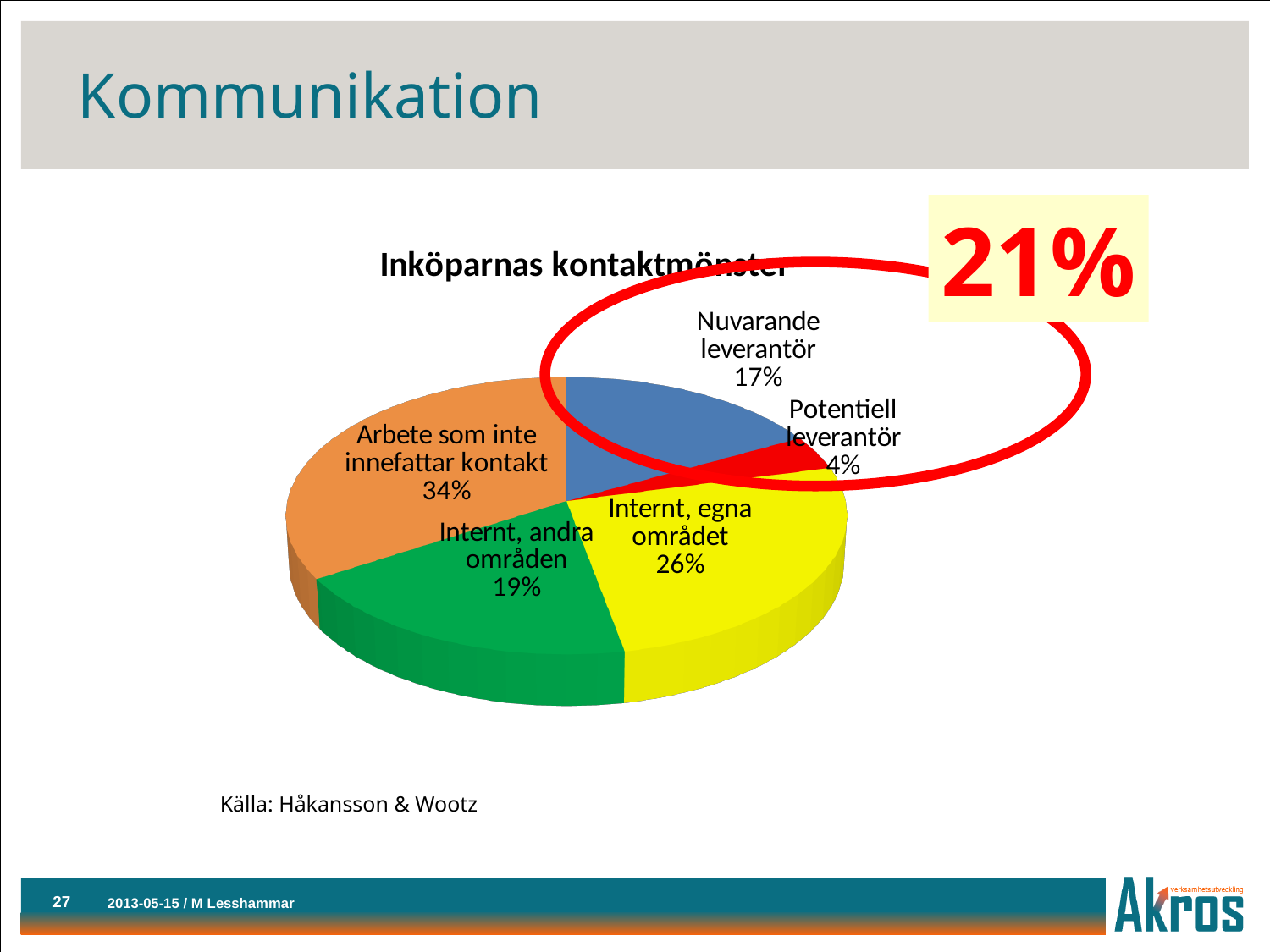
What kind of chart is shown on the slide? Pie chart What share of the pie is labelled "Internt, egna området"? 26% Which is larger, the share for "Nuvarande leverantör" or the share for "Internt, andra områden"? Internt, andra områden Which slice of the pie is the largest? Arbete som inte innefattar kontakt What share of the pie is labelled "Arbete som inte innefattar kontakt"? 34% What is the difference between the shares for "Internt, egna området" and "Internt, andra områden"? 7% What share of the pie is labelled "Internt, andra områden"? 19% What is the title of the chart? Inköparnas kontaktmönster How many slices does the pie chart have? 5 What share of the pie is labelled "Potentiell leverantör"? 4% Which slice of the pie is the smallest? Potentiell leverantör What share of the pie is labelled "Nuvarande leverantör"? 17%